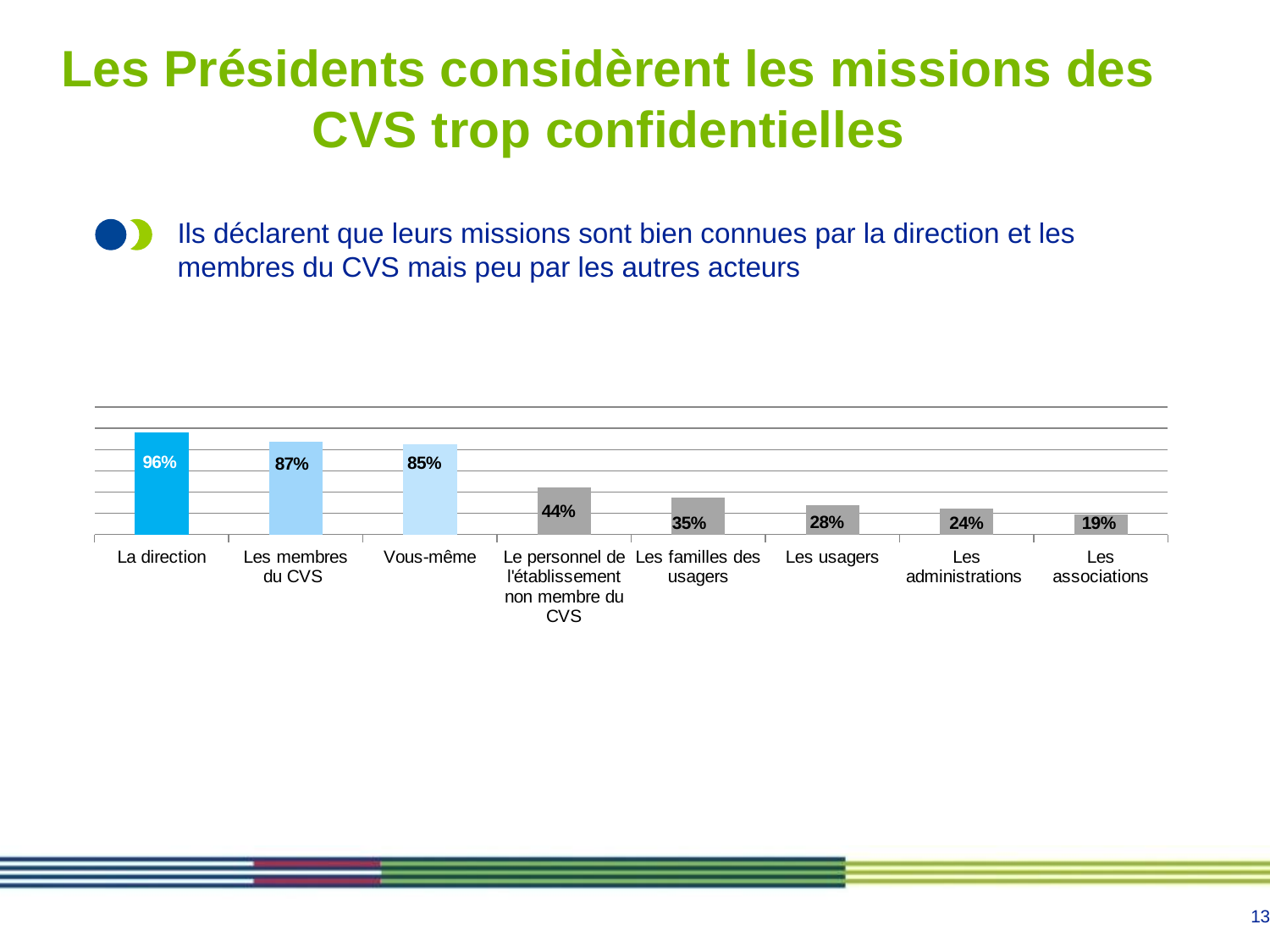
What is the difference between the values for La direction and Les usagers? 68% What is the value for Les administrations? 24% Which category has the lowest value? Les associations What is the value for La direction? 96% What kind of chart is shown on the slide? Bar chart Which category has the highest value? La direction What is the value for Les membres du CVS? 87% What is the difference between the values for Vous-même and Les familles des usagers? 50% Which is larger, the value for Les usagers or the value for Les administrations? Les usagers Do the values rise or fall from left to right across the categories? Fall How many categories are shown in the chart? 8 What is the value for Le personnel de l'établissement non membre du CVS? 44%